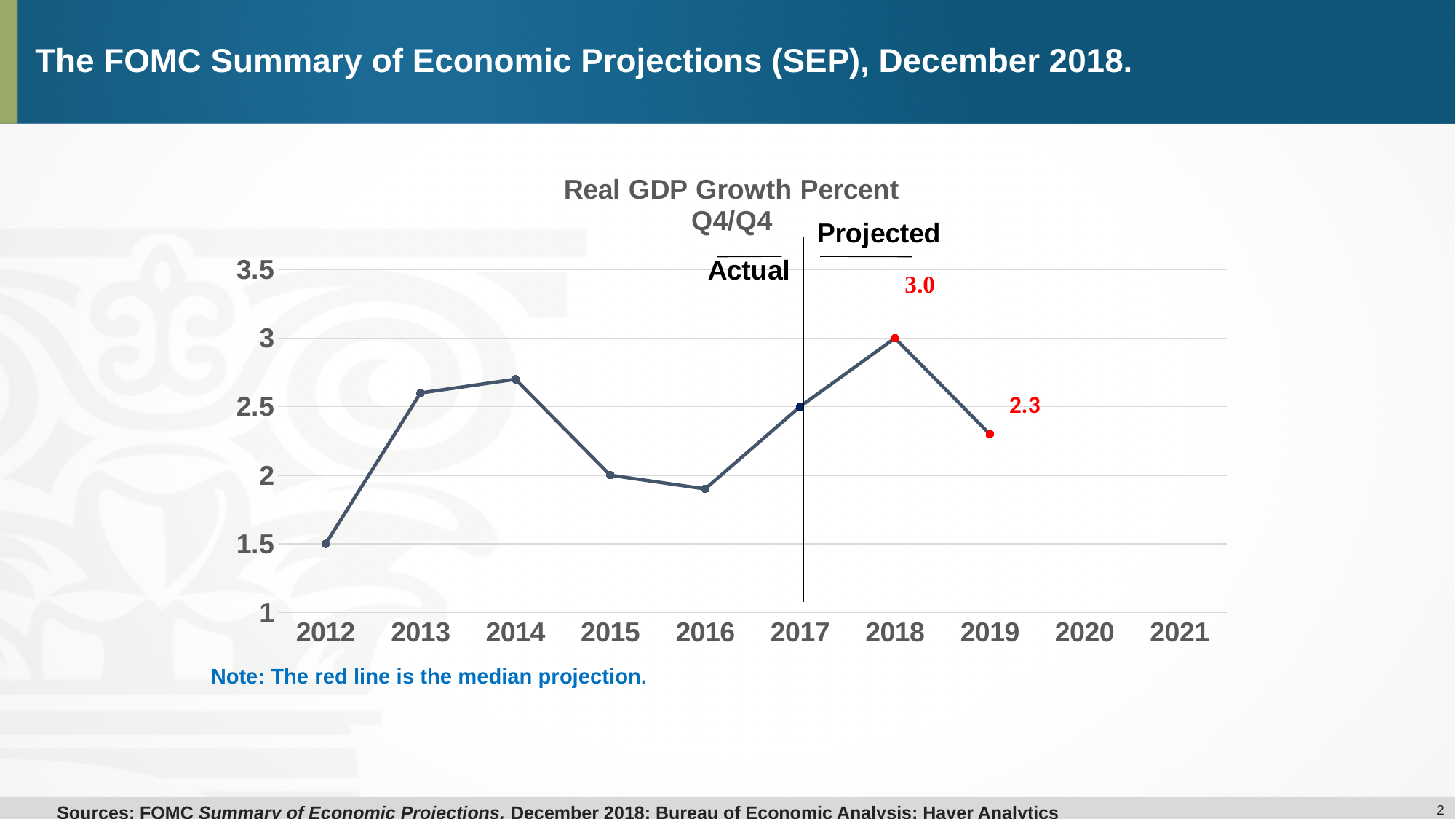
According to the note, what does the red line represent? the median projection Do the values rise or fall from 2014 to 2016? fall What is the projected real GDP growth value for 2019? 2.3 Which year has the highest real GDP growth value on the chart? 2018 Is the value for 2013 greater or less than 2.5? greater What is the projected real GDP growth value for 2018? 3.0 How many data points are plotted on the line? 8 Is the value for 2016 greater or less than 2? less What kind of chart is shown on the slide? line chart Which year has the larger value, 2014 or 2015? 2014 What is the difference between the 2018 and 2019 values? 0.7 Which year has the lowest real GDP growth value on the chart? 2012